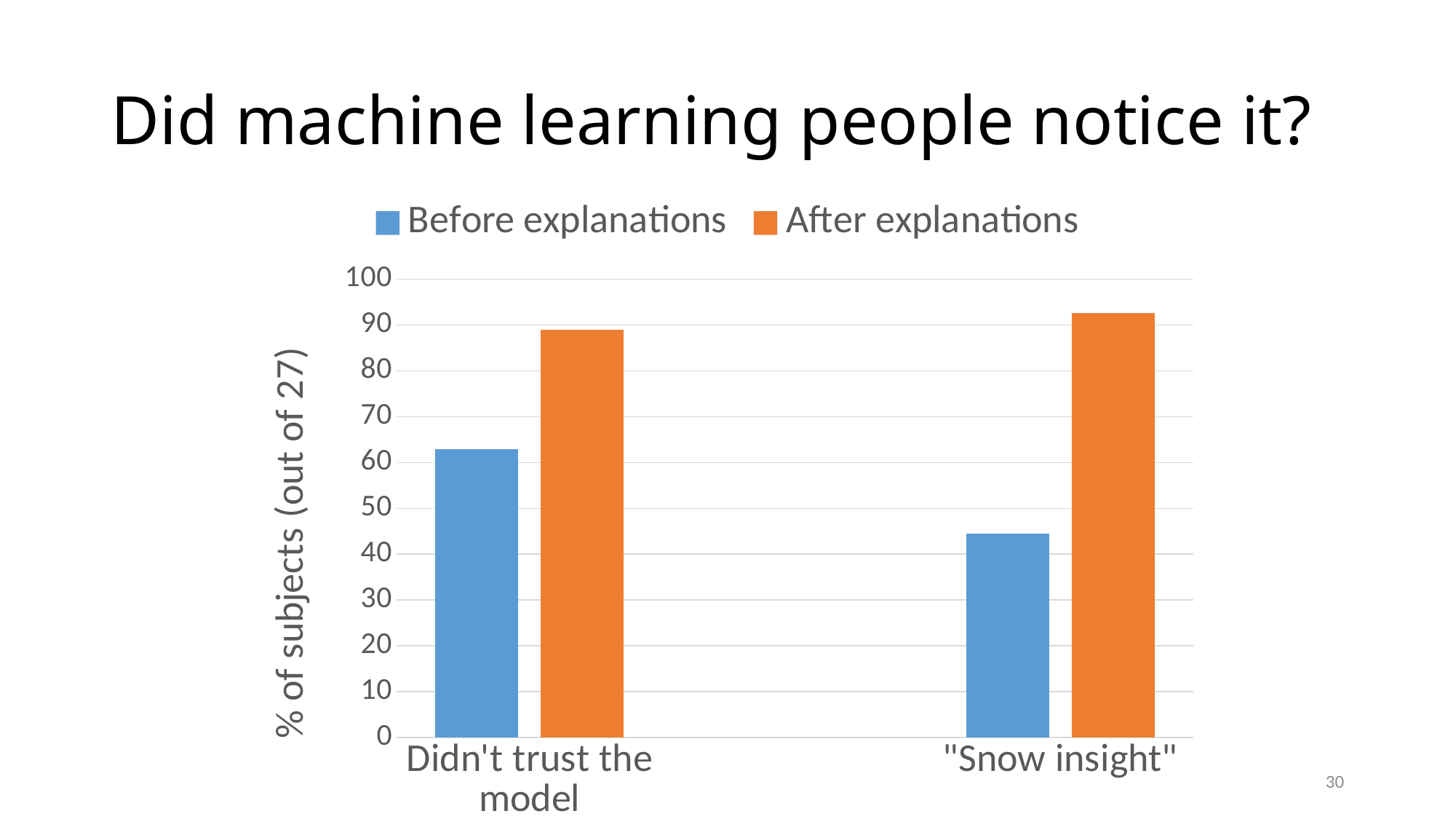
How many categories are shown on the x axis? 2 What colour are the After explanations bars? orange Is the After explanations value for "Snow insight" greater or less than 90? greater Is the Before explanations value for "Snow insight" greater or less than 50? less What kind of chart is shown on the slide? bar chart How many series does the legend list? 2 What is the label of the y axis? % of subjects (out of 27) Which series is higher for "Didn't trust the model", Before explanations or After explanations? After explanations Is the Before explanations value for "Didn't trust the model" greater or less than 50? greater Which series is higher for "Snow insight", Before explanations or After explanations? After explanations Which bar is the lowest in the chart? Before explanations for "Snow insight"